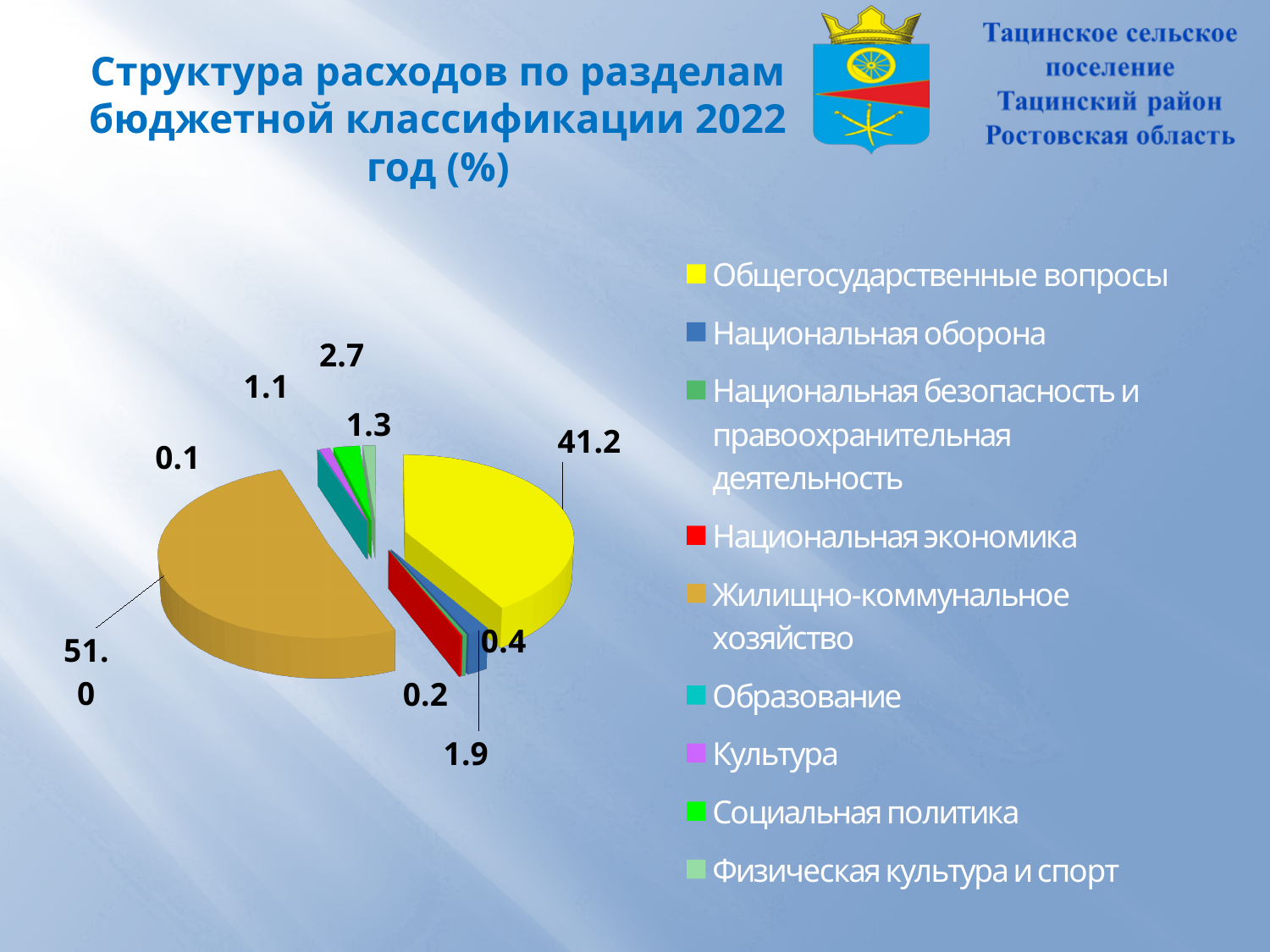
What is the value shown for Физическая культура и спорт? 1.3 What is the value shown for Жилищно-коммунальное хозяйство? 51.0 What colour is the slice for Общегосударственные вопросы? yellow What is the value shown for Общегосударственные вопросы? 41.2 Which category has the smallest share of the pie chart? Образование Which is larger, the value for Национальная экономика or the value for Образование? Национальная экономика What is the value shown for Образование? 0.1 What is the value shown for Национальная экономика? 0.2 What type of chart is shown on the slide? pie chart Which category has the largest share of the pie chart? Жилищно-коммунальное хозяйство What is the difference between the values for Жилищно-коммунальное хозяйство and Общегосударственные вопросы? 9.8 How many categories does the legend of the pie chart list? 9